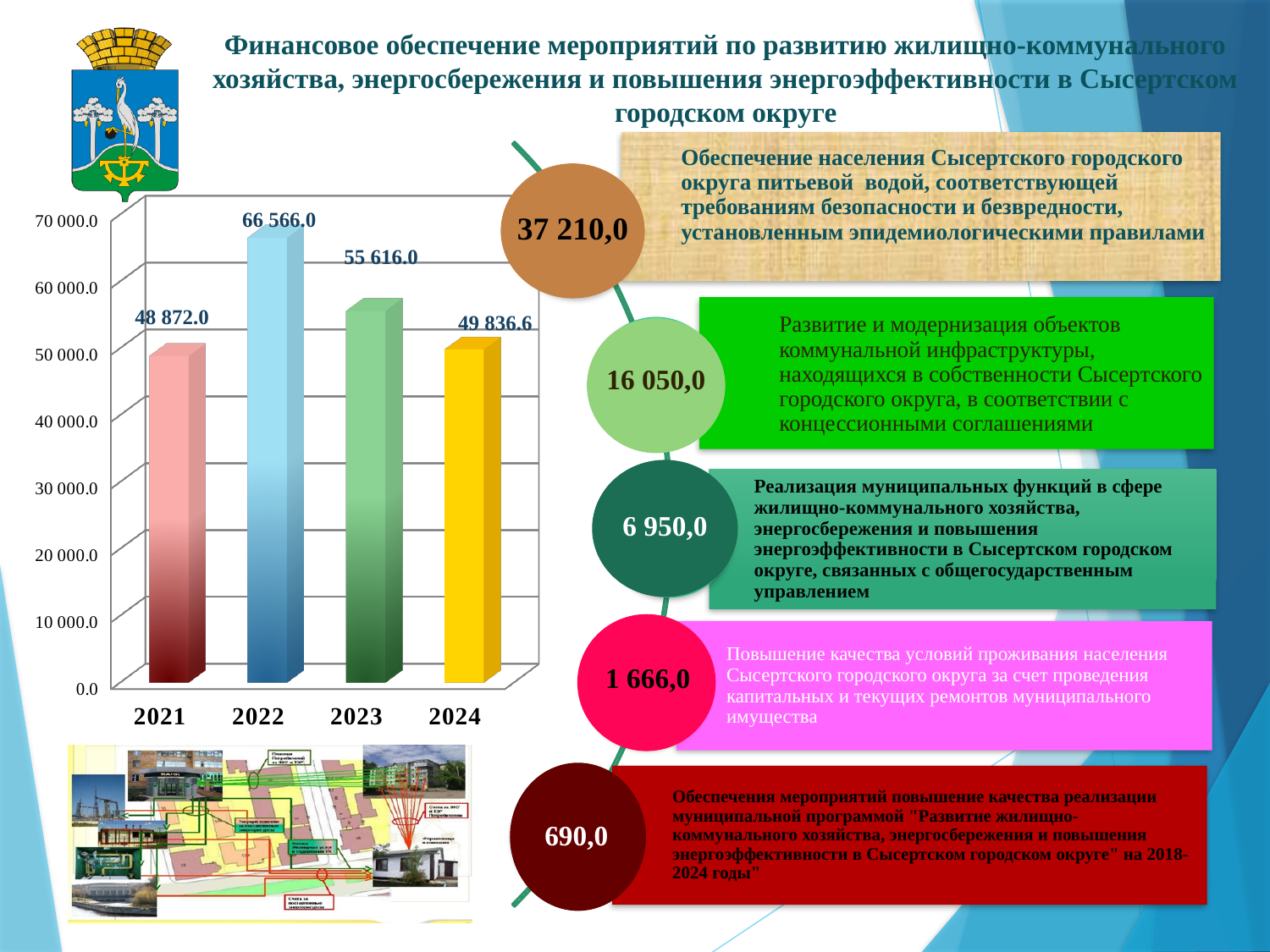
What is the value shown for 2022 on the bar chart? 66 566.0 What kind of chart is shown on the left of the slide? bar chart Which year has the lowest value on the bar chart? 2021 How many years (bars) are shown on the bar chart? 4 What is the value shown for 2021 on the bar chart? 48 872.0 Which is larger on the bar chart, the value for 2022 or the value for 2023? 2022 What is the difference between the values for 2022 and 2021 on the bar chart? 17 694.0 What is the value shown for 2024 on the bar chart? 49 836.6 Which year has the highest value on the bar chart? 2022 What is the value shown for 2023 on the bar chart? 55 616.0 What is the difference between the values for 2023 and 2024 on the bar chart? 5 779.4 Is the value for 2022 on the bar chart greater or less than 60 000.0? greater